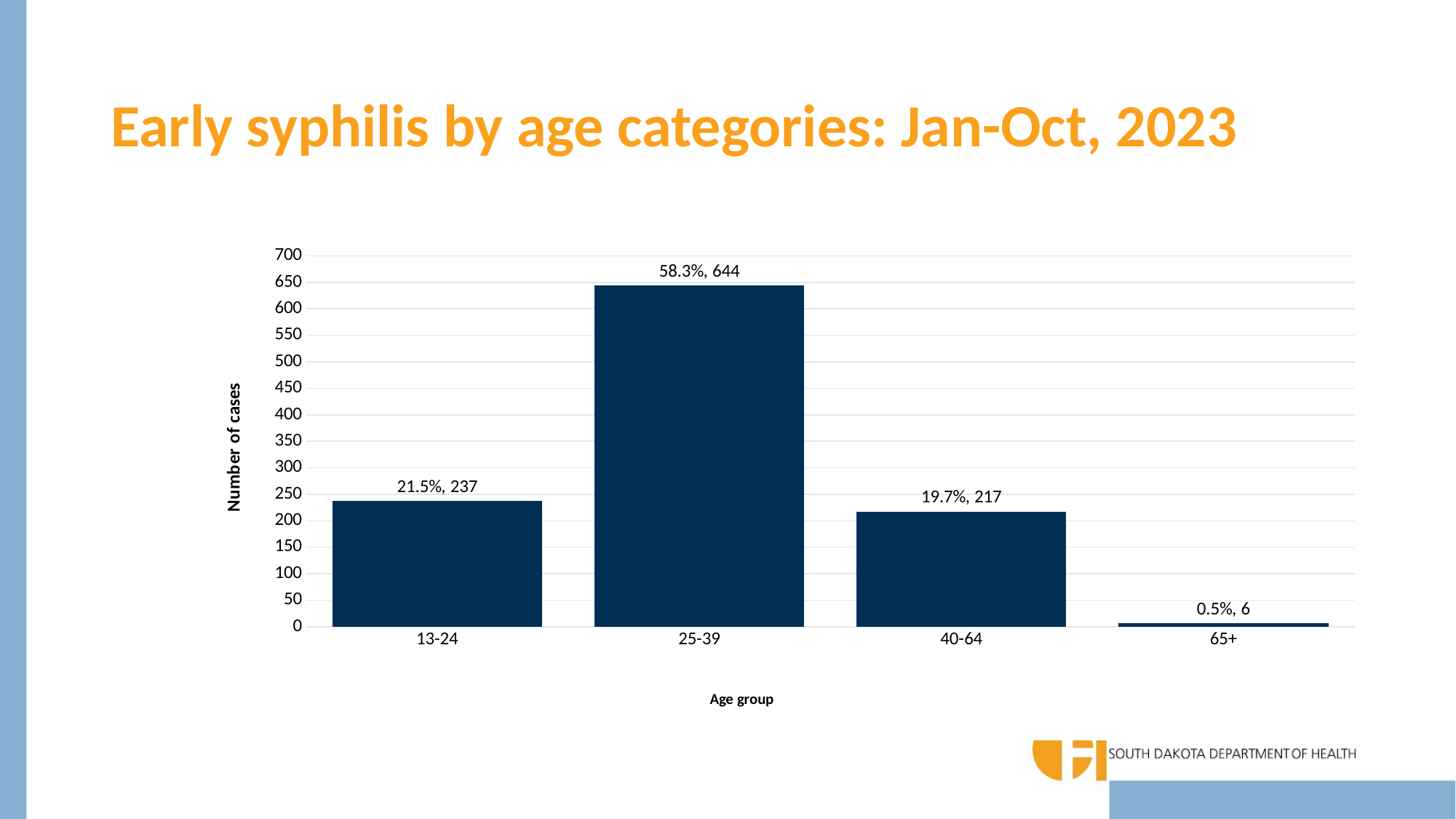
What percentage of early syphilis cases were in the 13-24 age group? 21.5% What percentage of cases were in the 40-64 age group? 19.7% Which age group has more cases, 13-24 or 40-64? 13-24 How many age groups are shown on the chart? 4 What type of chart is shown on the slide? Bar chart How many early syphilis cases were in the 25-39 age group? 644 Which age group has the highest number of cases? 25-39 Which age group has the lowest number of cases? 65+ What is the label of the y-axis? Number of cases What is the difference in number of cases between the 13-24 and 40-64 age groups? 20 What is the difference in number of cases between the 25-39 and 40-64 age groups? 427 How many cases were reported for the 65+ age group? 6